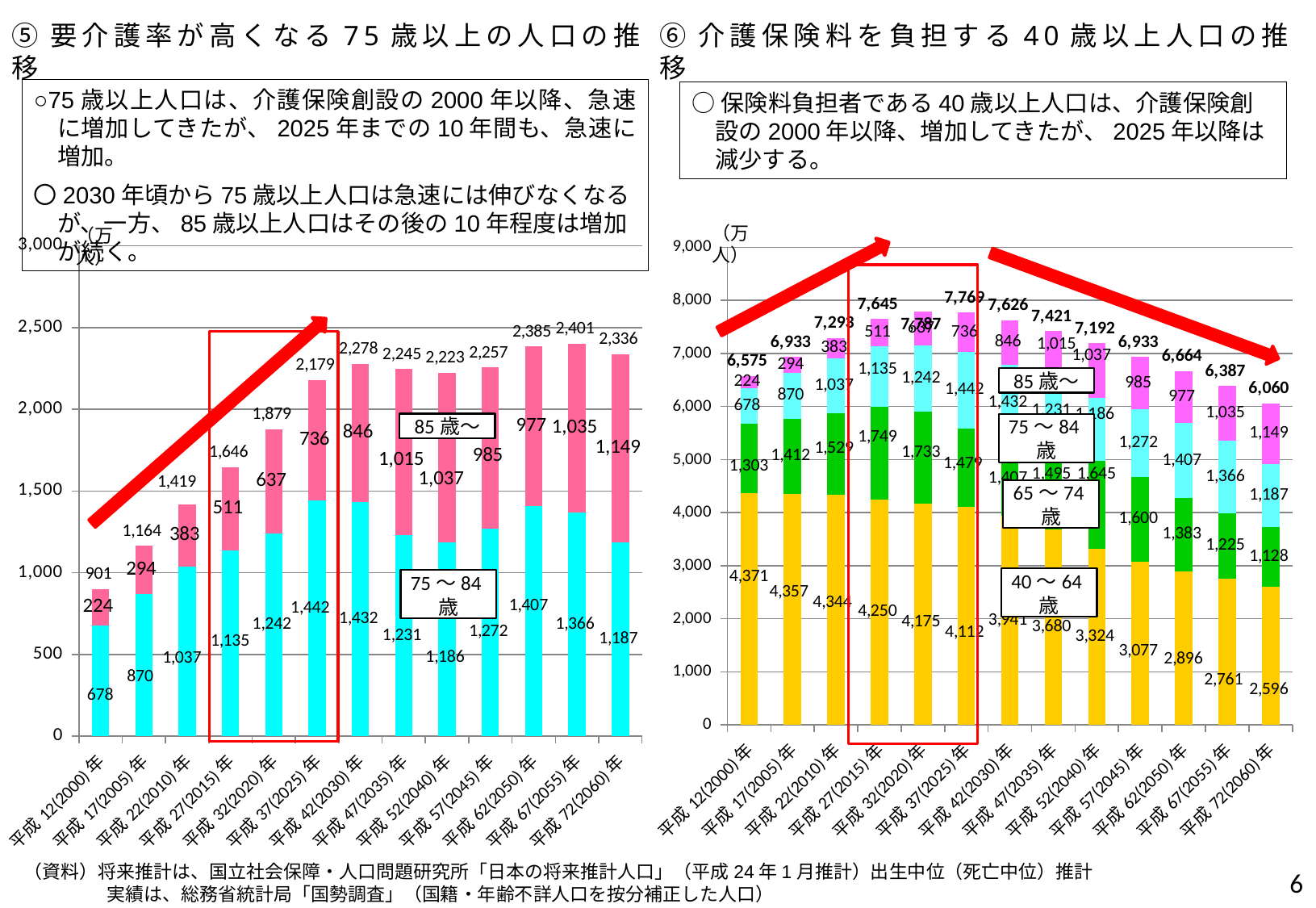
In the right chart (⑥), is the 65～74歳 value larger in 平成27(2015)年 or in 平成72(2060)年? 平成27(2015)年 In the right chart (⑥), does the 40～64歳 value rise or fall from 平成12(2000)年 to 平成72(2060)年? fall In the left chart (⑤), which year has the highest total 75歳以上 population? 平成67(2055)年 In the left chart (⑤), what is the difference between the total for 平成37(2025)年 and the total for 平成27(2015)年? 533 What kind of chart is the left chart (⑤ 要介護率が高くなる75歳以上の人口の推移)? bar chart In the right chart (⑥), what is the total 40歳以上 population for 平成72(2060)年? 6,060 How many age-group series are stacked in the right chart (⑥)? 4 In the left chart (⑤), what is the total 75歳以上 population shown for 平成37(2025)年? 2,179 In the right chart (⑥ 介護保険料を負担する40歳以上人口の推移), what is the 40～64歳 value for 平成72(2060)年? 2,596 In the left chart (⑤), which year has the lowest total 75歳以上 population? 平成12(2000)年 How many years (bars) are shown in the left chart (⑤)? 13 In the left chart (⑤), what is the 85歳～ value for 平成72(2060)年? 1,149